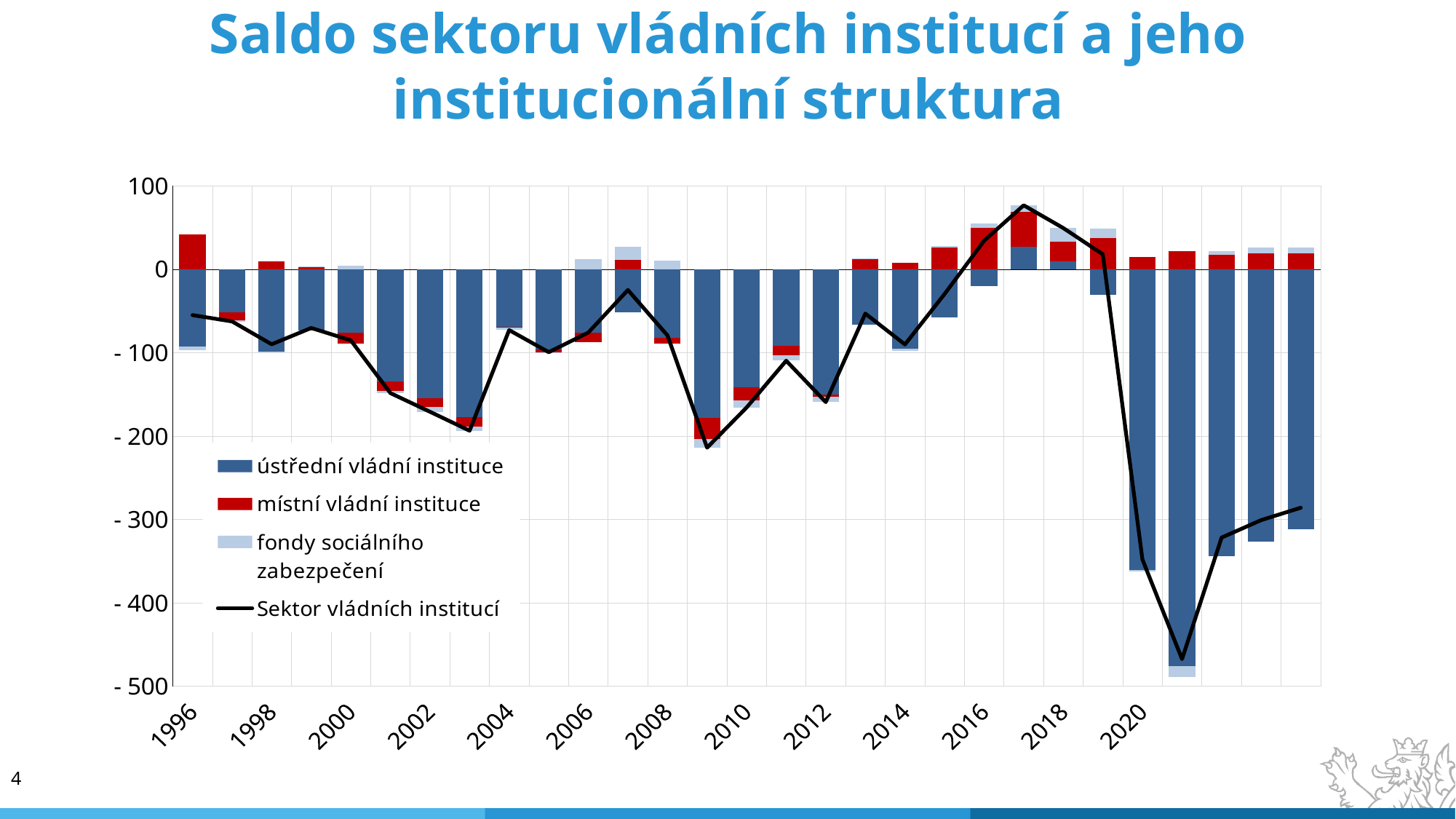
What kind of chart is shown on the slide? stacked bar chart with a line Which series is shown in red in the legend? místní vládní instituce How many series does the legend list? 4 Is the value of the Sektor vládních institucí line for 2017 greater or less than 50? greater Is the value of the Sektor vládních institucí line for 2020 greater or less than -300? less In which year does the Sektor vládních institucí line reach its highest value? 2017 Is the value of the Sektor vládních institucí line for 1996 greater or less than -100? greater Does the Sektor vládních institucí line rise or fall from 2017 to 2021? fall In which year does the Sektor vládních institucí line reach its lowest value? 2021 What is the title of the chart? Saldo sektoru vládních institucí a jeho institucionální struktura Which year has the higher value on the Sektor vládních institucí line, 2009 or 2020? 2009